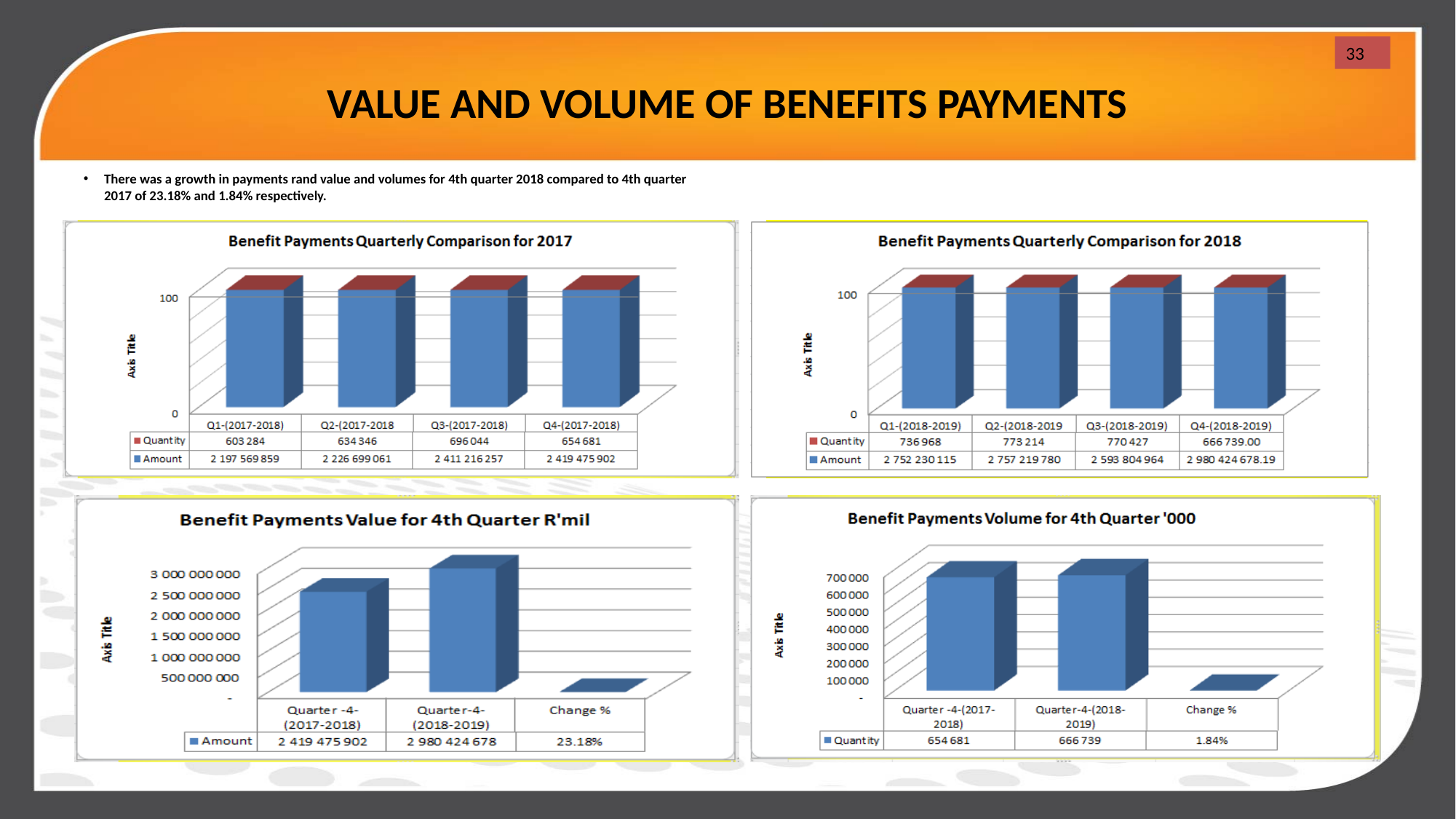
In the 'Benefit Payments Volume for 4th Quarter '000' chart, which is larger, the Quantity for Quarter-4-(2017-2018) or Quarter-4-(2018-2019)? Quarter-4-(2018-2019) In the 'Benefit Payments Volume for 4th Quarter '000' chart, what is the difference in Quantity between Quarter-4-(2018-2019) and Quarter-4-(2017-2018)? 12 058 In the 'Benefit Payments Quarterly Comparison for 2017' chart, what is the Quantity for Q3-(2017-2018)? 696 044 In the 'Benefit Payments Value for 4th Quarter R'mil' chart, what is the Change %? 23.18% In the 'Benefit Payments Quarterly Comparison for 2018' chart, what is the Amount for Q3-(2018-2019)? 2 593 804 964 In the 'Benefit Payments Quarterly Comparison for 2018' chart, how many series does the legend list? 2 In the 'Benefit Payments Quarterly Comparison for 2017' chart, which quarter has the lowest Quantity? Q1-(2017-2018) In the 'Benefit Payments Quarterly Comparison for 2018' chart, which quarter has the lowest Amount? Q3-(2018-2019) What kind of chart is the 'Benefit Payments Volume for 4th Quarter '000' chart? Bar chart In the 'Benefit Payments Quarterly Comparison for 2018' chart, which quarter has the highest Quantity? Q2-(2018-2019) In the 'Benefit Payments Quarterly Comparison for 2017' chart, what is the Amount for Q1-(2017-2018)? 2 197 569 859 In the 'Benefit Payments Value for 4th Quarter R'mil' chart, what is the difference in Amount between Quarter-4-(2018-2019) and Quarter-4-(2017-2018)? 560 948 776